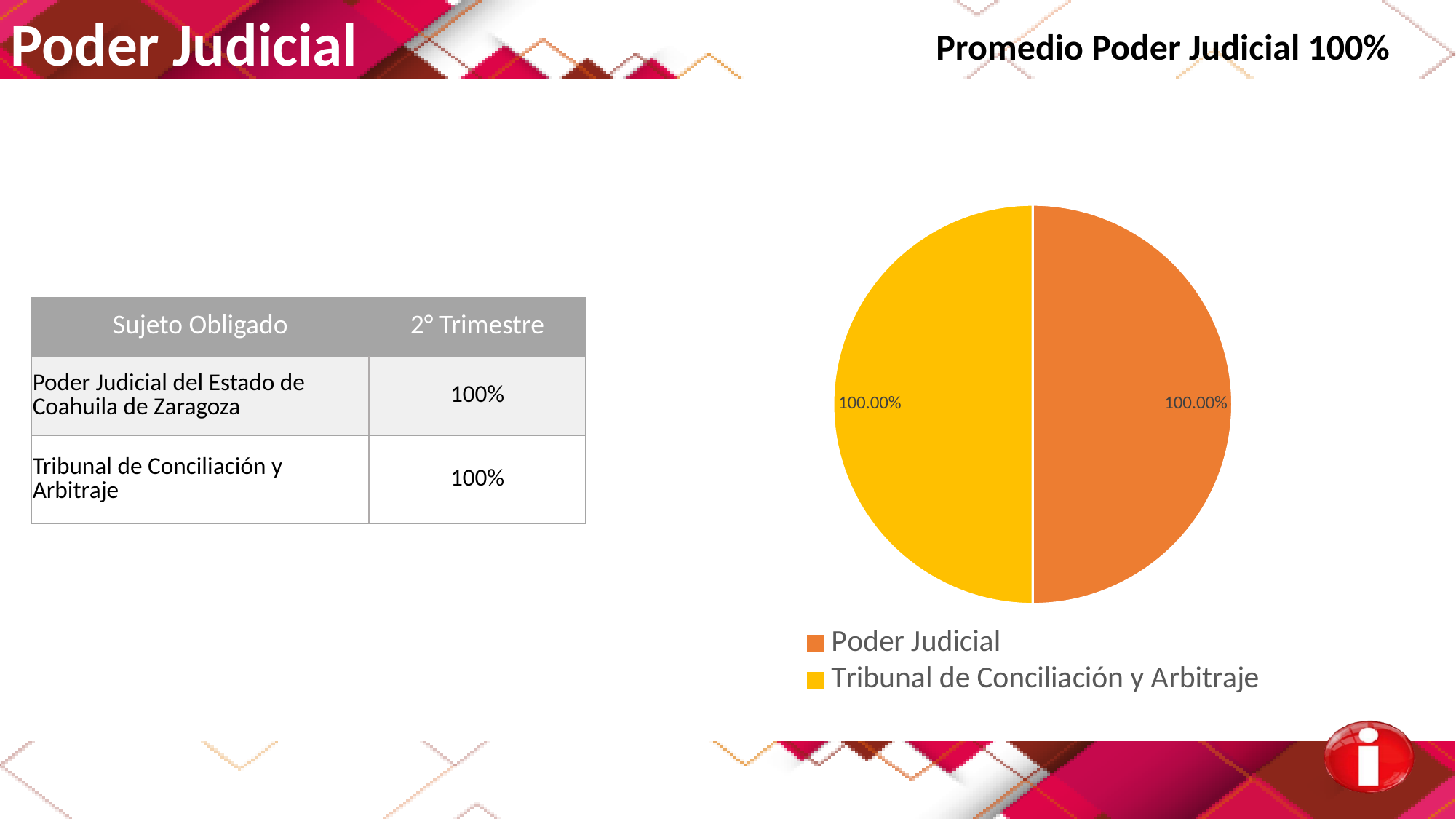
How many entries does the legend of the pie chart list? 2 How many slices does the pie chart have? 2 What is the difference between the labelled values of the Poder Judicial slice and the Tribunal de Conciliación y Arbitraje slice? 0.00% Which legend entry is listed first in the pie chart's legend? Poder Judicial What value is labelled on the Tribunal de Conciliación y Arbitraje slice of the pie chart? 100.00% Which colour represents Poder Judicial in the pie chart? orange What value is labelled on the Poder Judicial slice of the pie chart? 100.00% Which colour represents Tribunal de Conciliación y Arbitraje in the pie chart? yellow What kind of chart is shown on the slide? pie chart